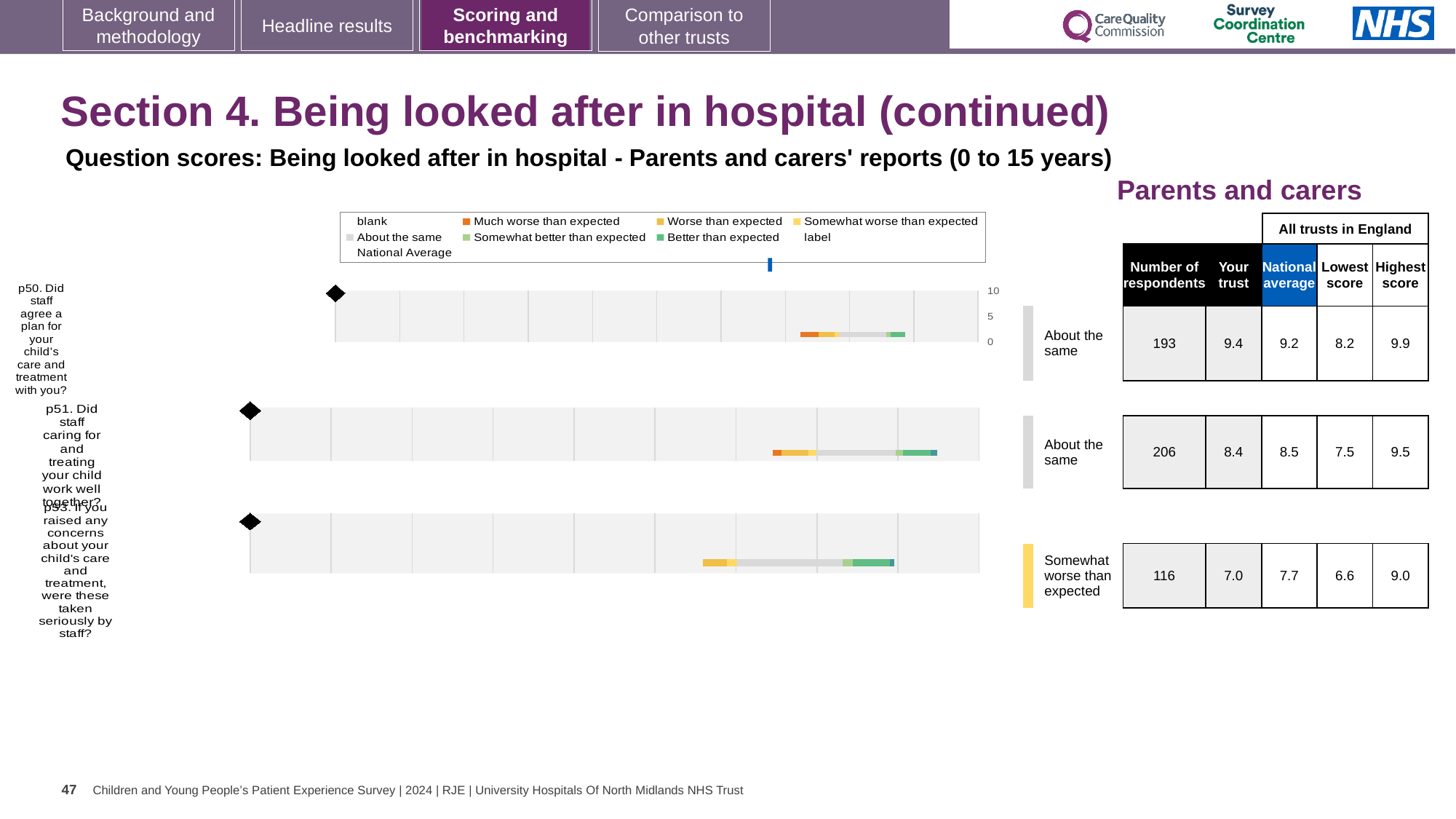
For the p53 chart (If you raised any concerns about your child's care and treatment, were these taken seriously by staff?), what is the 'Your trust' score? 7.0 For the p51 chart, which is larger: the 'Your trust' score or the national average? National average How many question charts are shown on the slide? 3 Which benchmark category is the p53 chart labelled with? Somewhat worse than expected Which of the three questions has the highest 'Your trust' score? p50 What is the highest tick value shown on the chart axis? 10 For the p50 chart (Did staff agree a plan for your child's care and treatment with you?), what is the 'Your trust' score? 9.4 What kind of chart is used to show the benchmark bands for each question on this slide? bar chart Which of the three questions has the lowest 'Your trust' score? p53 For the p51 chart (Did staff caring for and treating your child work well together?), what is the national average score? 8.5 For the p53 chart, what is the difference between the national average and the 'Your trust' score? 0.7 How many entries does the chart legend list? 9